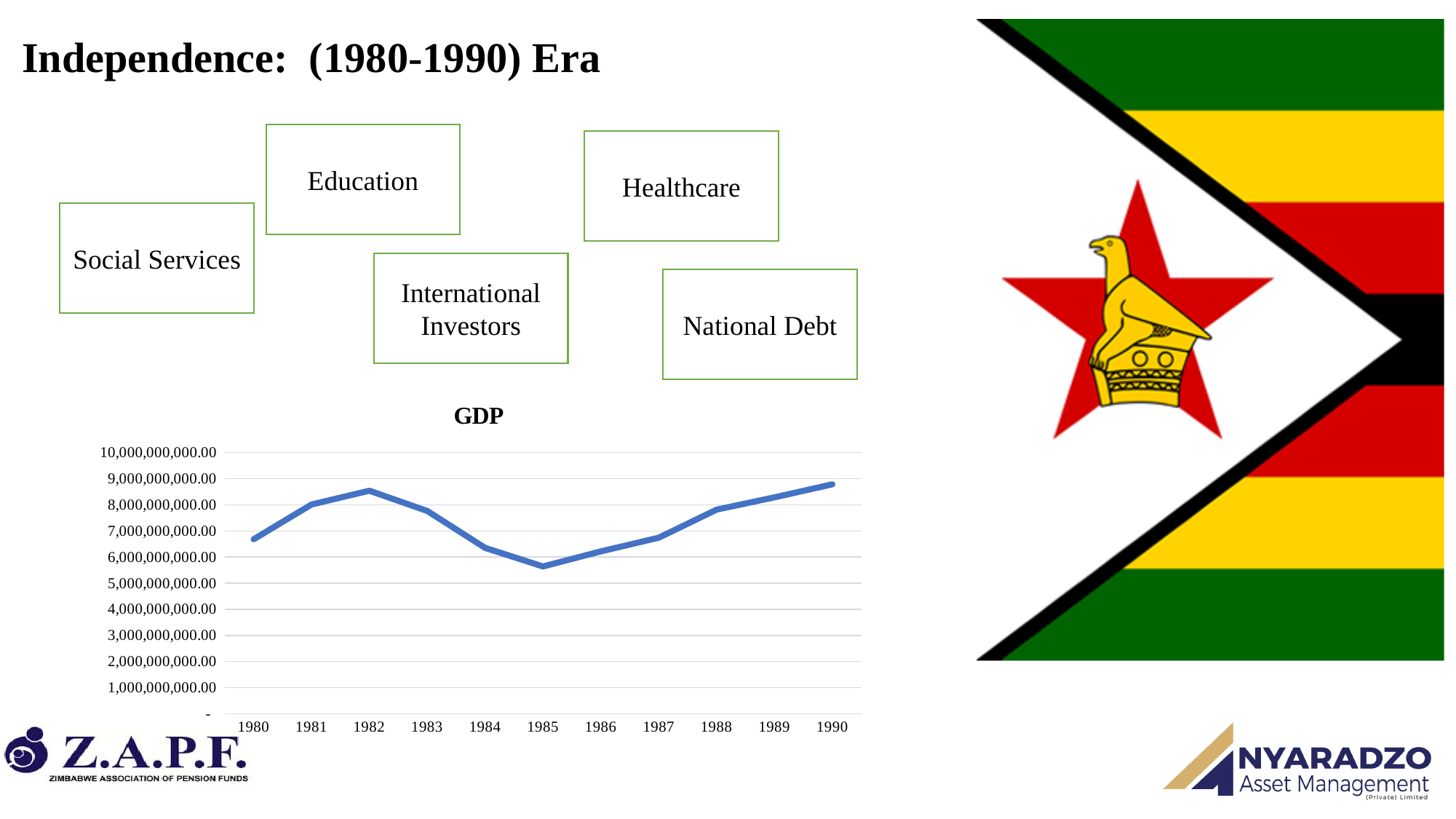
Does GDP rise or fall between 1985 and 1990? rise How many years are plotted on the x axis of the GDP chart? 11 Is the GDP value for 1980 greater or less than 7,000,000,000.00? less In which year is GDP highest on the chart? 1990 What is the title of the chart? GDP Which year has the higher GDP, 1981 or 1984? 1981 Is the GDP value for 1985 greater or less than 6,000,000,000.00? less What type of chart is shown on the slide? line chart In which year is GDP lowest on the chart? 1985 Is the GDP value for 1982 greater or less than 8,000,000,000.00? greater Which year has the higher GDP, 1982 or 1985? 1982